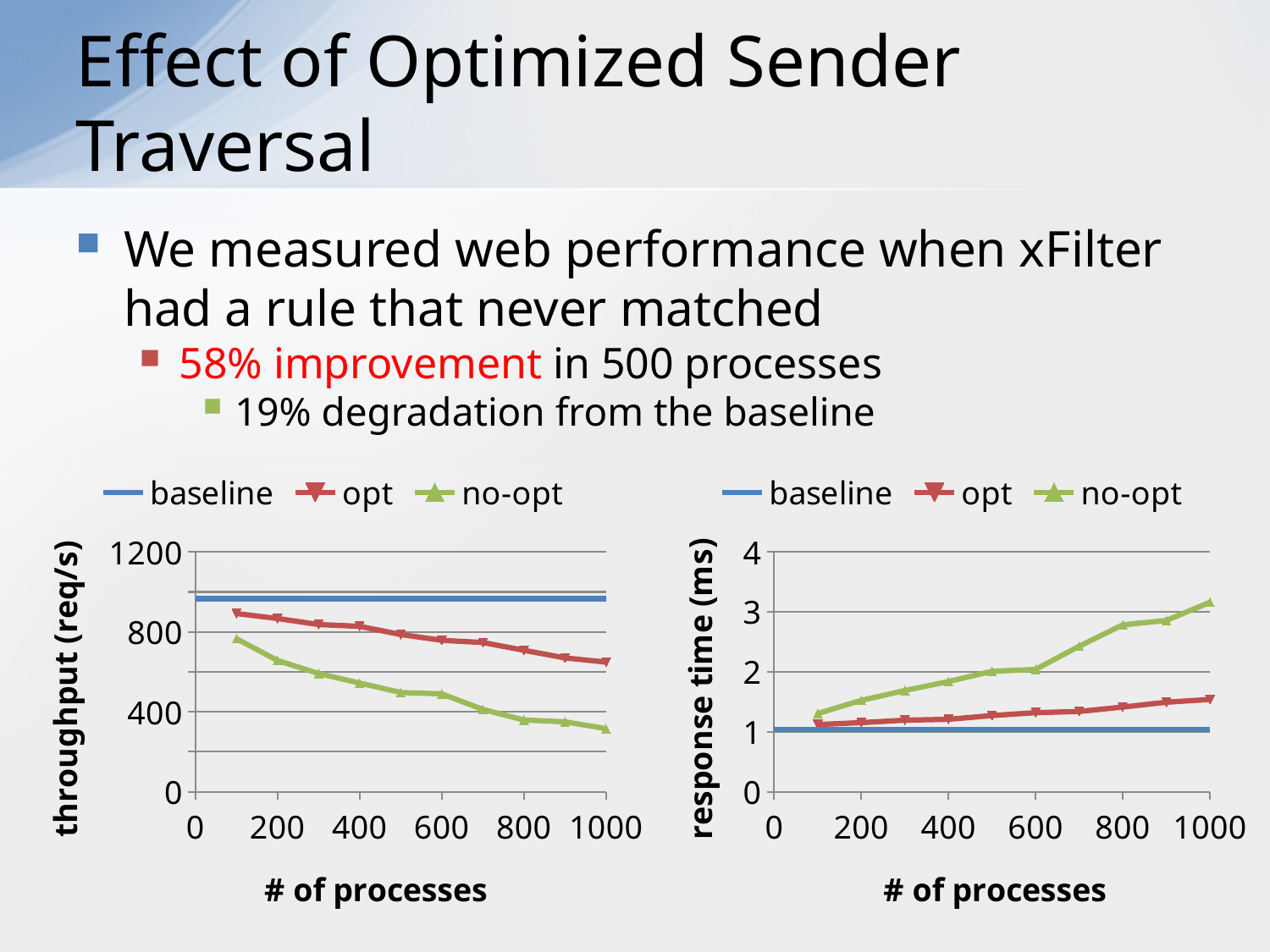
What kind of chart is the left chart (throughput)? line chart What is the x-axis label of the left chart? # of processes In the left chart (throughput), is the opt value at 100 processes greater or less than 800? greater In the left chart (throughput), which series has the higher value at 1000 processes, opt or no-opt? opt What is the y-axis label of the right chart? response time (ms) How many series does the legend of the right chart (response time) list? 3 In the left chart (throughput), does the no-opt series rise or fall as the number of processes increases? fall In the right chart (response time), is the no-opt value at 1000 processes greater or less than 3? greater In the right chart (response time), which series has the higher value at 800 processes, opt or no-opt? no-opt In the right chart (response time), is the opt value at 1000 processes greater or less than 2? less In the right chart (response time), does the opt series rise or fall as the number of processes increases? rise